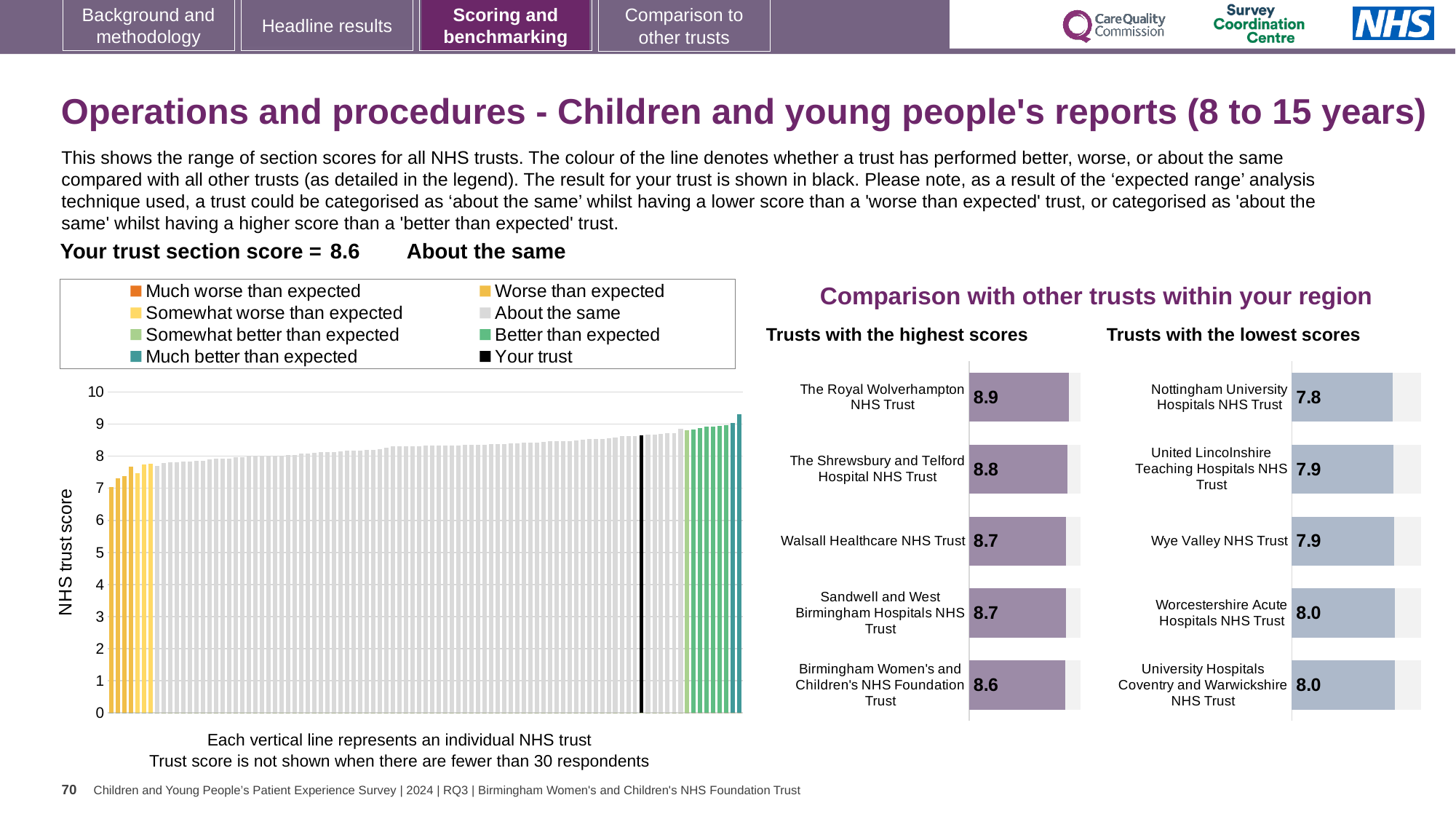
In the 'Trusts with the lowest scores' chart, which trust has the lowest score? Nottingham University Hospitals NHS Trust In the 'Trusts with the highest scores' chart, what is the difference between the scores of The Royal Wolverhampton NHS Trust and Birmingham Women's and Children's NHS Foundation Trust? 0.3 In the 'Trusts with the highest scores' chart, what is the score for Walsall Healthcare NHS Trust? 8.7 In the 'Trusts with the lowest scores' chart, what is the score for Nottingham University Hospitals NHS Trust? 7.8 In the 'Trusts with the lowest scores' chart, what is the difference between the scores of Worcestershire Acute Hospitals NHS Trust and Nottingham University Hospitals NHS Trust? 0.2 In the 'Trusts with the highest scores' chart, what is the score for The Royal Wolverhampton NHS Trust? 8.9 In the 'Trusts with the highest scores' chart, which has the larger score: The Shrewsbury and Telford Hospital NHS Trust or Walsall Healthcare NHS Trust? The Shrewsbury and Telford Hospital NHS Trust How many entries does the legend of the large chart on the left list? 8 In the 'Trusts with the highest scores' chart, how many trusts are listed? 5 In the 'Trusts with the highest scores' chart, which trust has the highest score? The Royal Wolverhampton NHS Trust In the 'Trusts with the lowest scores' chart, what is the score for Wye Valley NHS Trust? 7.9 What kind of chart is the large chart on the left showing NHS trust scores? bar chart